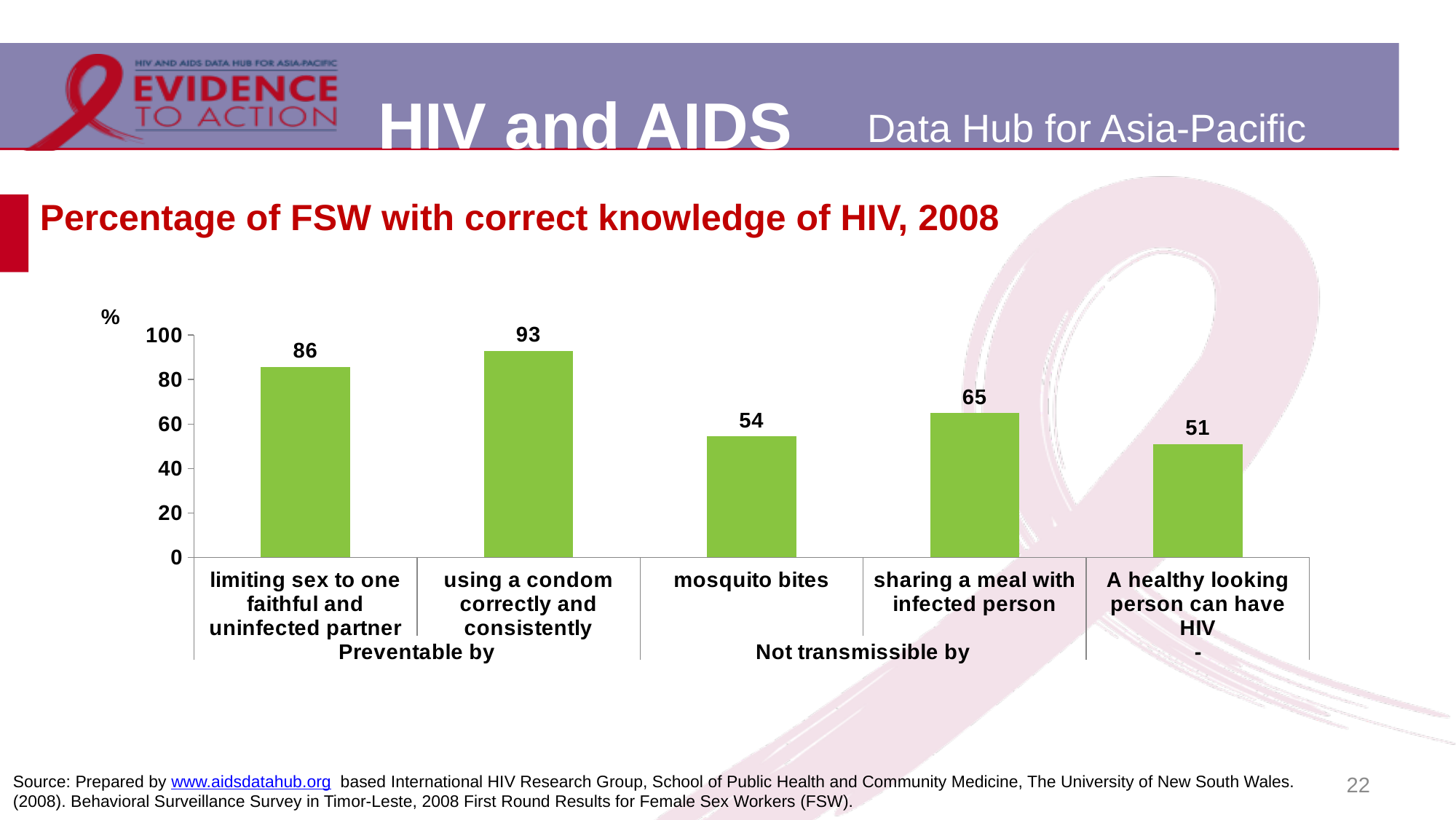
What is the value for 'mosquito bites'? 54 What percentage of FSW knew that a healthy looking person can have HIV? 51 What percentage of FSW had correct knowledge that HIV is preventable by using a condom correctly and consistently? 93 Which is larger: the value for 'limiting sex to one faithful and uninfected partner' or the value for 'sharing a meal with infected person'? limiting sex to one faithful and uninfected partner How many categories are shown in the chart? 5 Which category has the lowest value? A healthy looking person can have HIV What is the value for 'sharing a meal with infected person'? 65 Which category has the highest value? using a condom correctly and consistently What kind of chart is shown on the slide? bar chart What is the difference between the values for 'using a condom correctly and consistently' and 'limiting sex to one faithful and uninfected partner'? 7 What is the title of the chart? Percentage of FSW with correct knowledge of HIV, 2008 What is the difference between the values for 'sharing a meal with infected person' and 'mosquito bites'? 11